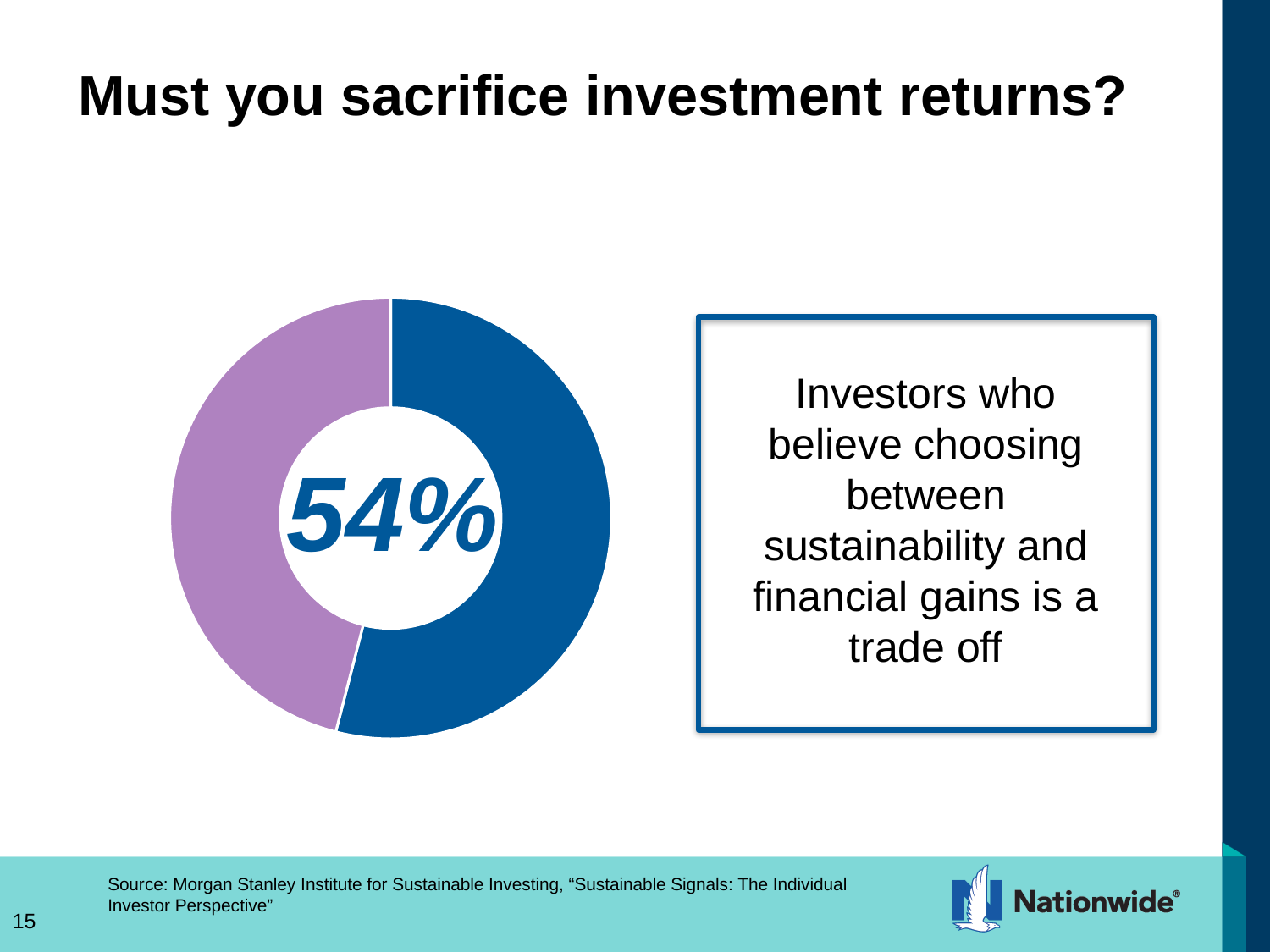
Which slice of the donut chart is larger, the blue one or the purple one? the blue one What kind of chart is shown on the slide? donut (pie) chart Is the purple slice of the donut chart greater or less than 50%? less Is the blue slice of the donut chart greater or less than 50%? greater What share of investors believe choosing between sustainability and financial gains is a trade off, according to the chart? 54% What percentage is printed in the centre of the donut chart? 54% What is the title of the slide containing the donut chart? Must you sacrifice investment returns? What two colours are used for the slices of the donut chart? blue and purple How many slices does the donut chart have? 2